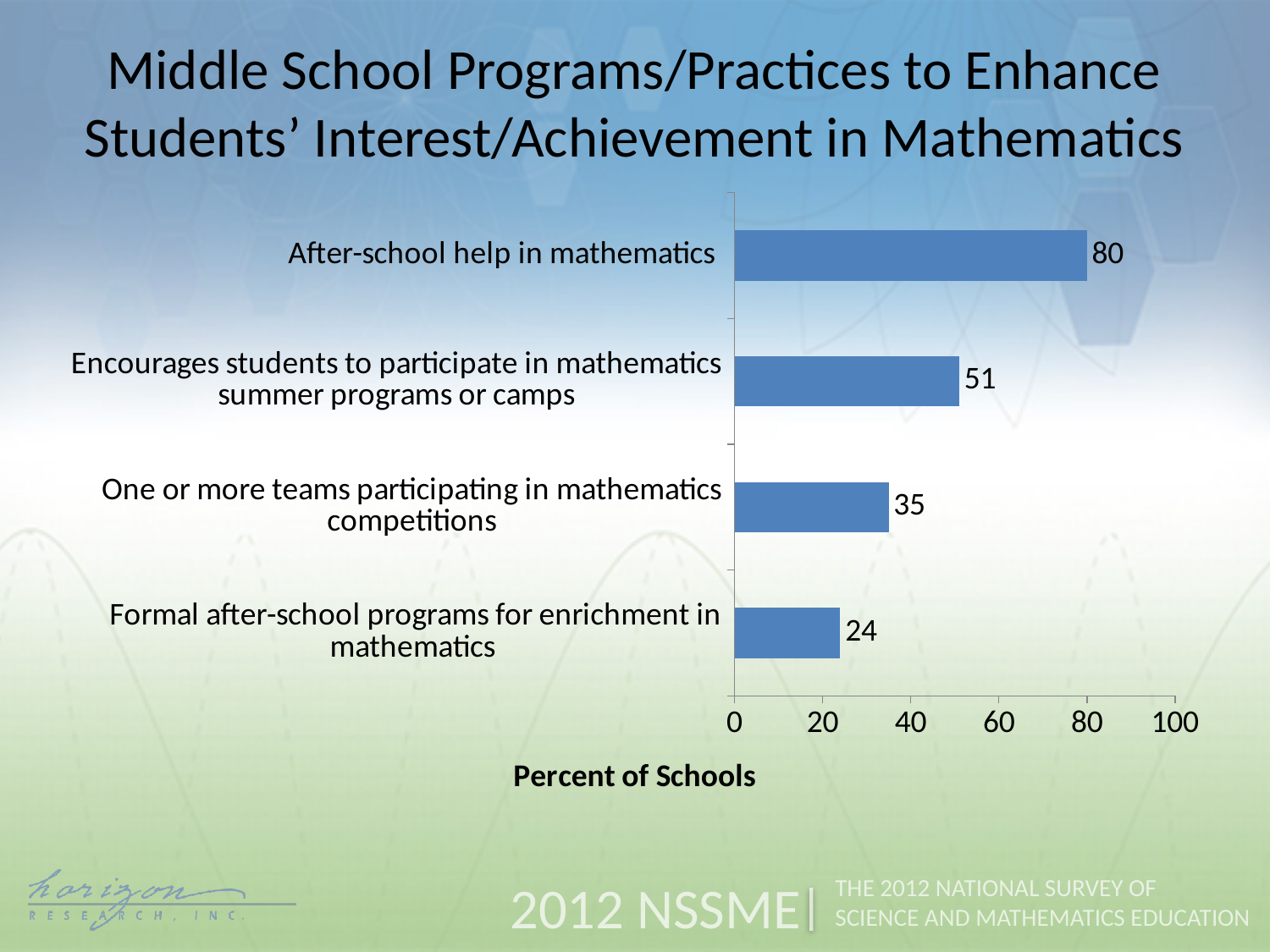
What is the difference between the value for summer programs or camps and the value for mathematics competitions? 16 What kind of chart is shown on the slide? Bar chart How many programs/practices are shown in the chart? 4 Which program/practice has the highest percent of schools? After-school help in mathematics What is the value for 'Encourages students to participate in mathematics summer programs or camps'? 51 What percent of schools offer after-school help in mathematics? 80 What is the difference between the value for after-school help in mathematics and the value for formal after-school programs for enrichment in mathematics? 56 What percent of schools have one or more teams participating in mathematics competitions? 35 Which is larger: the value for mathematics competitions or the value for formal after-school enrichment programs? One or more teams participating in mathematics competitions Which program/practice has the lowest percent of schools? Formal after-school programs for enrichment in mathematics What is the value for 'Formal after-school programs for enrichment in mathematics'? 24 What is the label of the horizontal axis? Percent of Schools